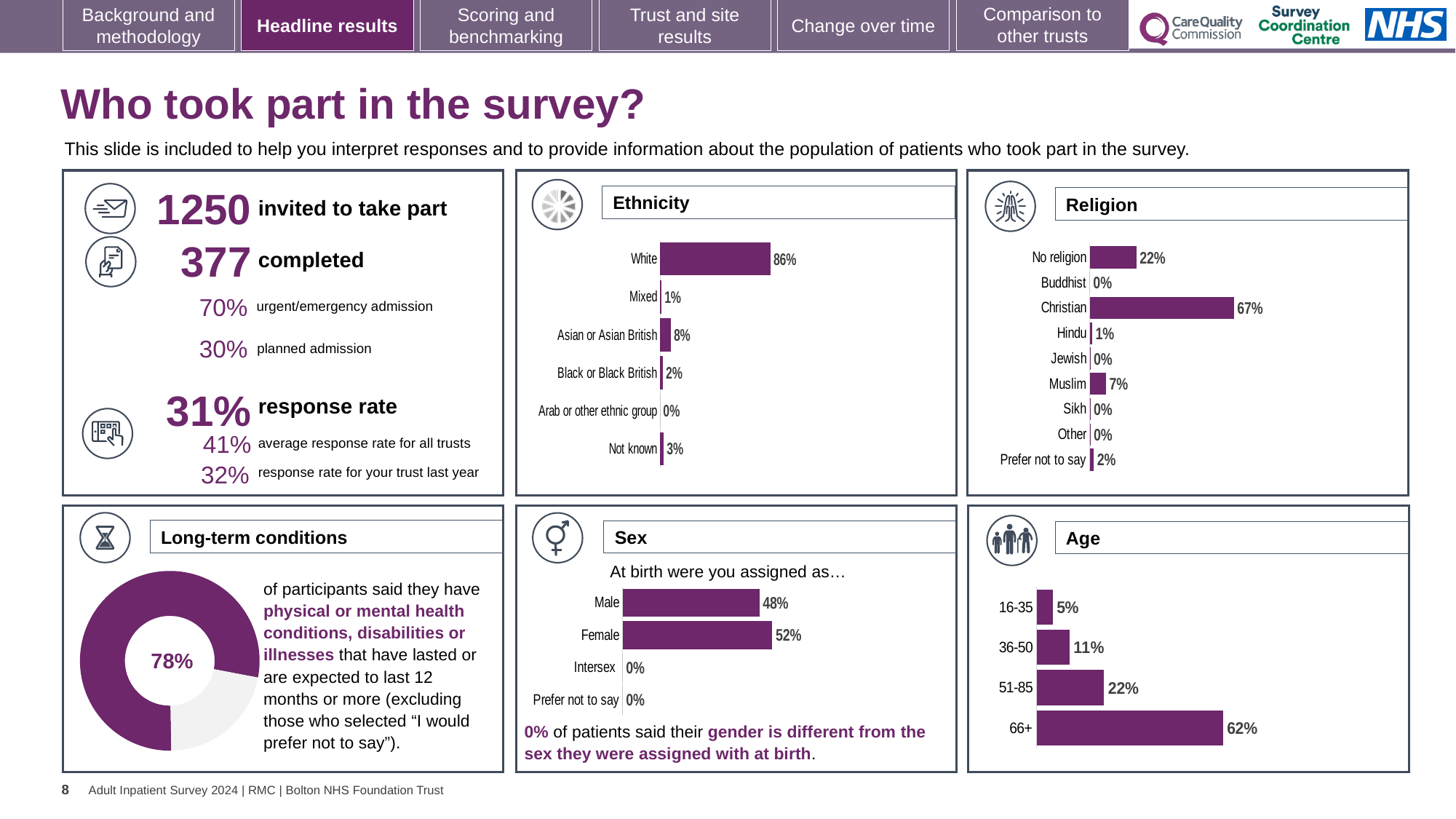
In the Religion chart, what is the difference between the Christian and No religion values? 45% In the Religion chart, what percentage of participants were Christian? 67% In the Ethnicity chart, how many categories are shown? 6 In the Long-term conditions chart, what share of participants said they have long-term conditions? 78% In the Age chart, what percentage of participants were aged 36-50? 11% In the Sex chart, what percentage of participants were assigned Female at birth? 52% In the Age chart, do the values rise or fall as the age groups increase? rise In the Ethnicity chart, what percentage of participants were White? 86% In the Ethnicity chart, which category has the highest value? White In the Sex chart, what is the difference between the Female and Male values? 4% In the Religion chart, which is larger, Muslim or Hindu? Muslim In the Age chart, which age group has the highest value? 66+